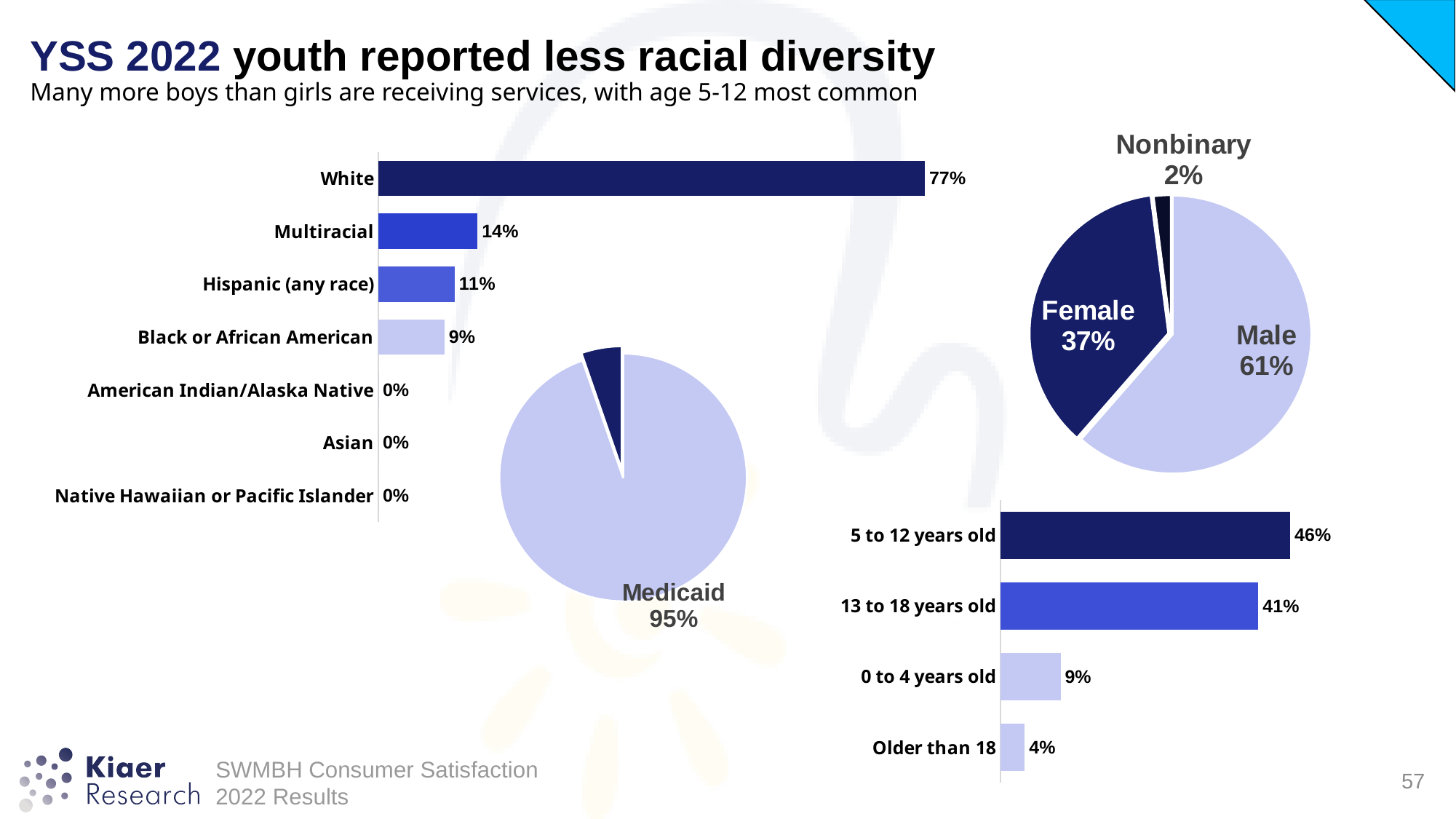
In the race bar chart on the left, what is the difference between the Multiracial and Black or African American values? 5% In the Medicaid pie chart in the middle, what share is labeled Medicaid? 95% In the race bar chart on the left, how many categories are listed? 7 In the race bar chart on the left, which category has the highest value? White In the gender pie chart on the upper right, what share is Female? 37% In the gender pie chart on the upper right, how many slices are there? 3 In the gender pie chart on the upper right, which slice is the smallest? Nonbinary In the age bar chart on the lower right, what percentage is shown for 13 to 18 years old? 41% In the race bar chart on the left, what percentage is shown for White? 77% In the age bar chart on the lower right, which is larger: 5 to 12 years old or 13 to 18 years old? 5 to 12 years old What kind of chart is the age chart on the lower right? Bar chart In the race bar chart on the left, what percentage is shown for Hispanic (any race)? 11%